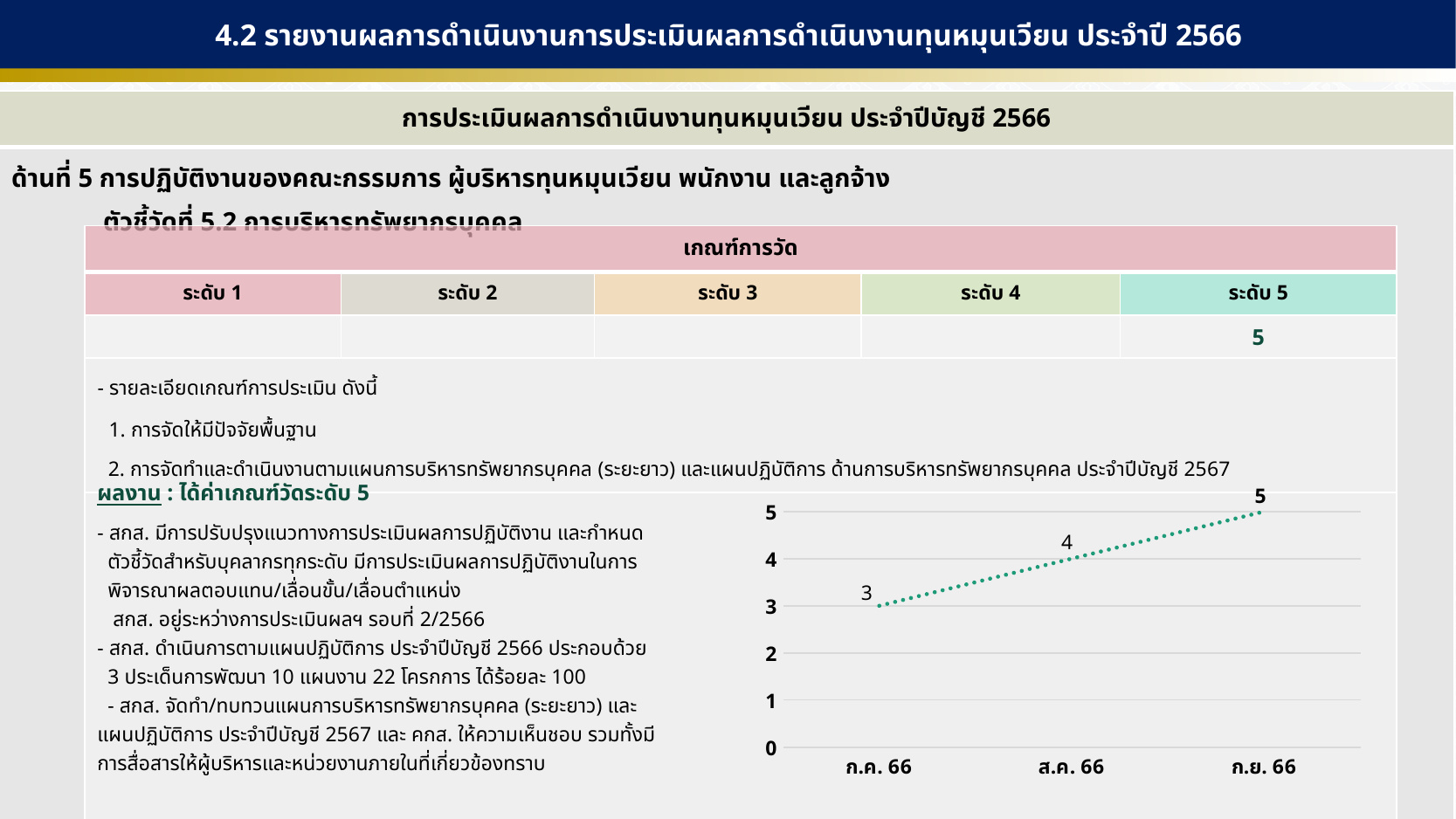
What is the value for ส.ค. 66 in the chart? 4 What is the difference between the values for ส.ค. 66 and ก.ค. 66? 1 Which month has the highest value in the chart? ก.ย. 66 What is the value for ก.ย. 66 in the chart? 5 Which is larger, the value for ส.ค. 66 or the value for ก.ค. 66? ส.ค. 66 Is the value for ก.ย. 66 greater or less than 4? greater How many data points are plotted in the chart? 3 What is the value for ก.ค. 66 in the chart? 3 Which month has the lowest value in the chart? ก.ค. 66 What is the difference between the values for ก.ย. 66 and ก.ค. 66? 2 Do the values rise or fall from ก.ค. 66 to ก.ย. 66? rise What kind of chart is shown on the slide? line chart